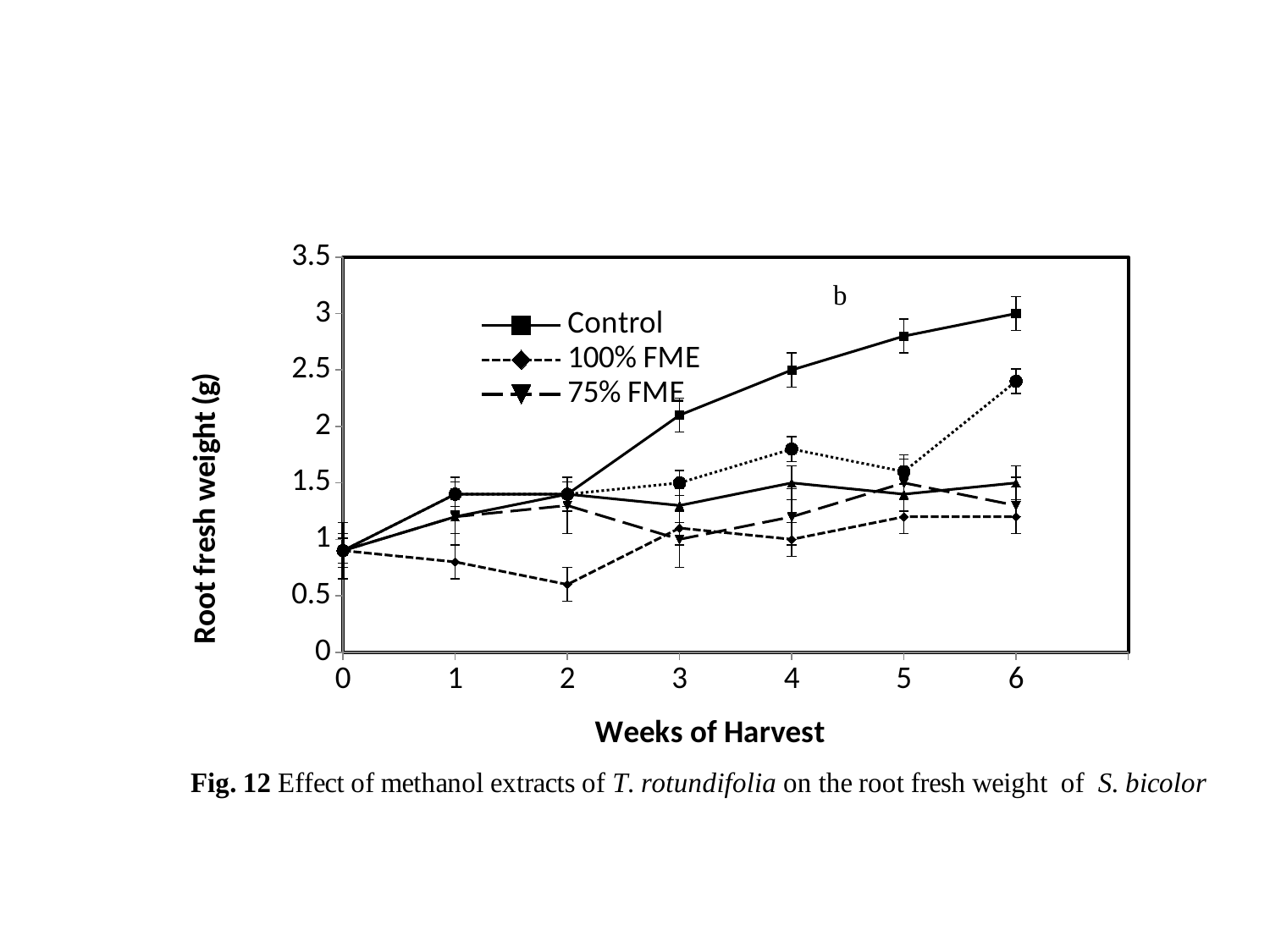
Which is larger at week 4, the Control value or the 100% FME value? Control Is the value for Control at week 6 greater or less than 2.5? greater How many weeks of harvest are plotted along the x axis? 7 How many series does the legend list? 3 Which series has the lowest root fresh weight at week 2? 100% FME What kind of chart is shown on the slide? line chart What is the label of the y axis? Root fresh weight (g) At which week does the Control series reach its highest value? 6 Which series has the highest root fresh weight at week 6? Control Is the value for 100% FME at week 2 greater or less than 1? less Does the Control series rise or fall from week 0 to week 6? rise At which week does the 100% FME series reach its lowest value? 2